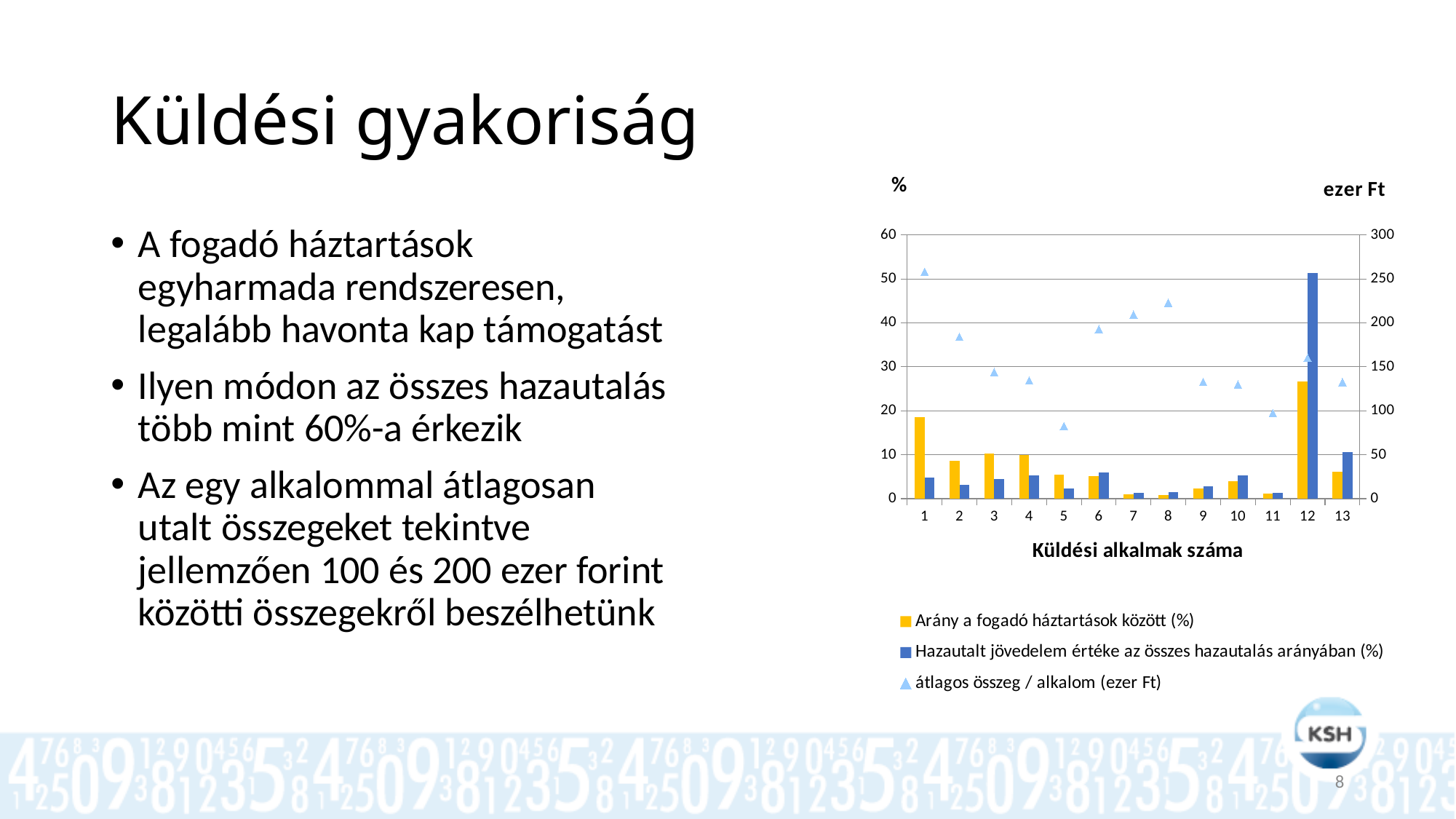
For which category is the bar for 'Hazautalt jövedelem értéke az összes hazautalás arányában (%)' the highest? 12 How many series does the chart's legend list? 3 For which category is the bar for 'Arány a fogadó háztartások között (%)' the highest? 12 How many categories are shown on the x axis of the chart? 13 For which category is the marker for 'átlagos összeg / alkalom (ezer Ft)' the highest? 1 Which is larger: the 'Arány a fogadó háztartások között (%)' bar for category 1 or for category 2? category 1 Is the value of 'Hazautalt jövedelem értéke az összes hazautalás arányában (%)' for category 12 greater or less than 40? greater Which is larger: the 'Hazautalt jövedelem értéke az összes hazautalás arányában (%)' bar for category 12 or for category 13? category 12 What is the title of the chart's x axis? Küldési alkalmak száma Is the value of 'átlagos összeg / alkalom (ezer Ft)' for category 5 greater or less than 100? less Is the value of 'Arány a fogadó háztartások között (%)' for category 1 greater or less than 10? greater What kind of chart is shown on the slide? bar chart (with an additional marker series)